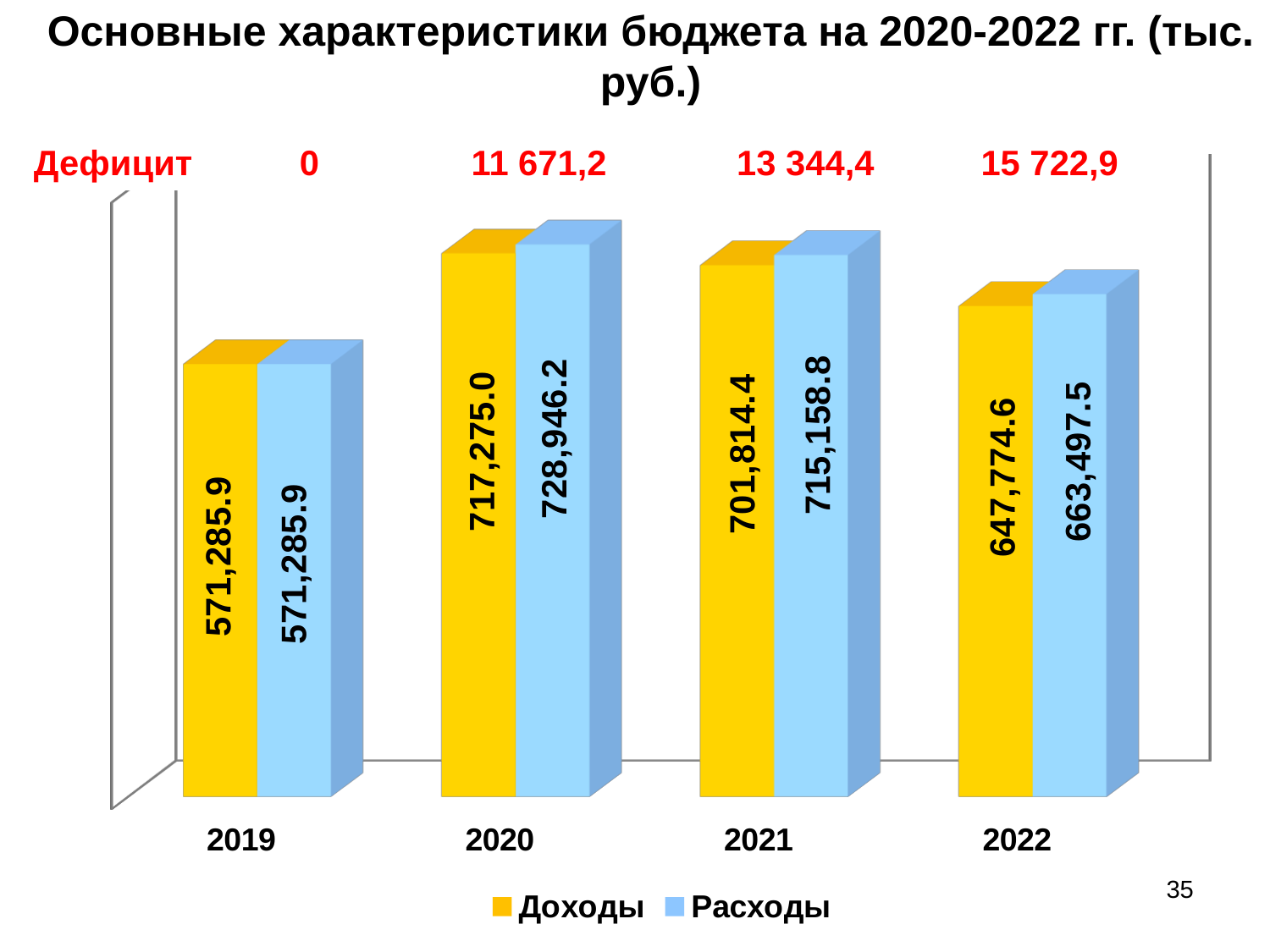
What is the value of Расходы for 2019? 571,285.9 What is the value of Расходы for 2022? 663,497.5 Which is larger in 2022, Доходы or Расходы? Расходы Which year has the highest value for Доходы? 2020 How many series does the legend list? 2 What is the difference between Расходы and Доходы in 2021? 13,344.4 How many years are shown on the x axis? 4 Which year has the lowest value for Расходы? 2019 What is the value of Доходы for 2020? 717,275.0 Do the values for Доходы rise or fall from 2020 to 2022? Fall What is the Дефицит value shown above the chart for 2022? 15 722,9 What kind of chart is shown on the slide? Bar chart